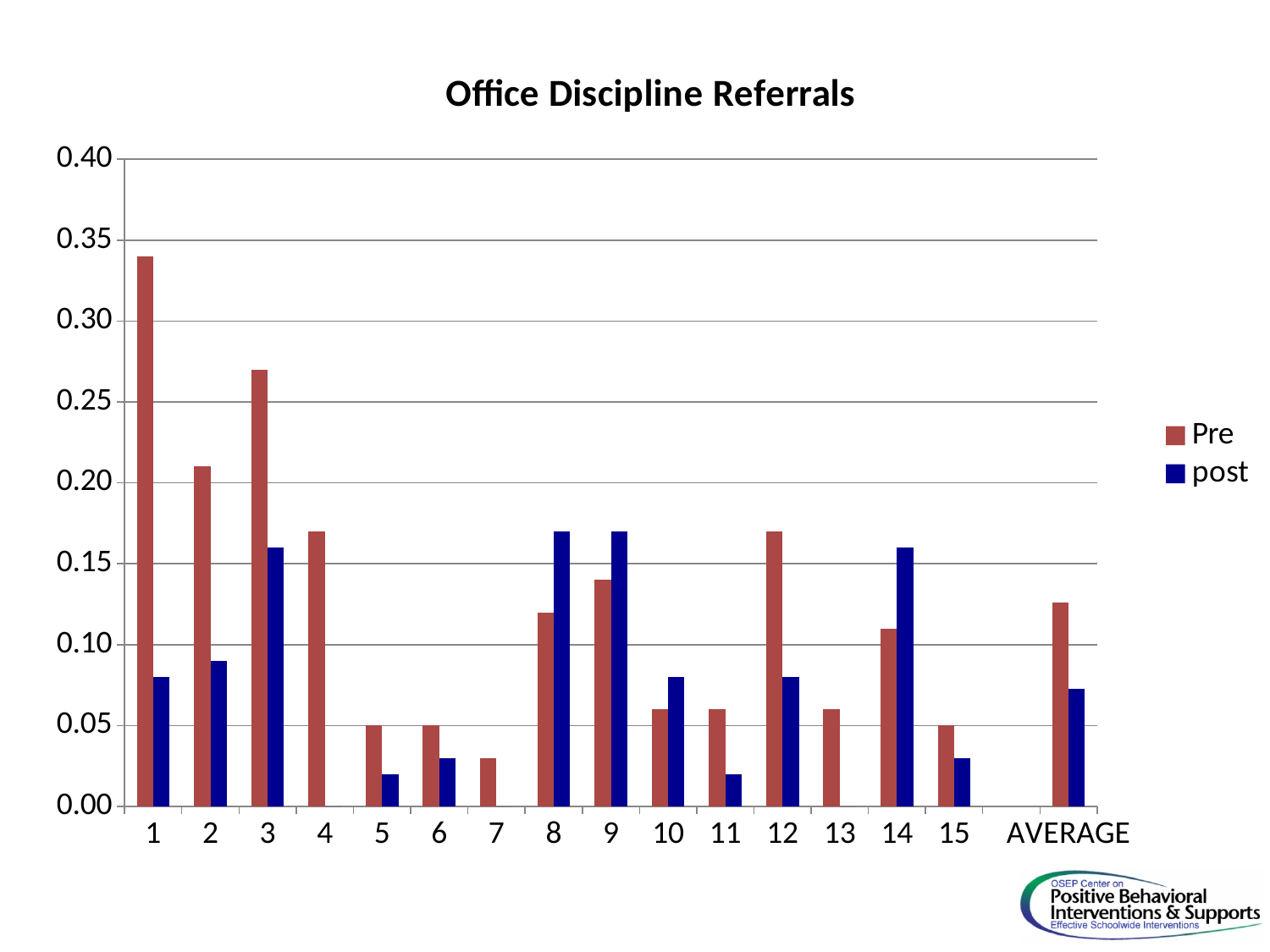
For category 8, which is larger, the Pre value or the post value? post For category 2, which is larger, the Pre value or the post value? Pre Is the post value for category 1 greater or less than 0.10? less Which category has the highest Pre value? 1 Is the Pre value for category 3 greater or less than 0.25? greater How many series does the legend list? 2 What kind of chart is shown on the slide? bar chart What is the title of the chart? Office Discipline Referrals Is the Pre value for AVERAGE greater or less than 0.10? greater How many categories are shown along the x axis? 16 Which category has the lowest Pre value? 7